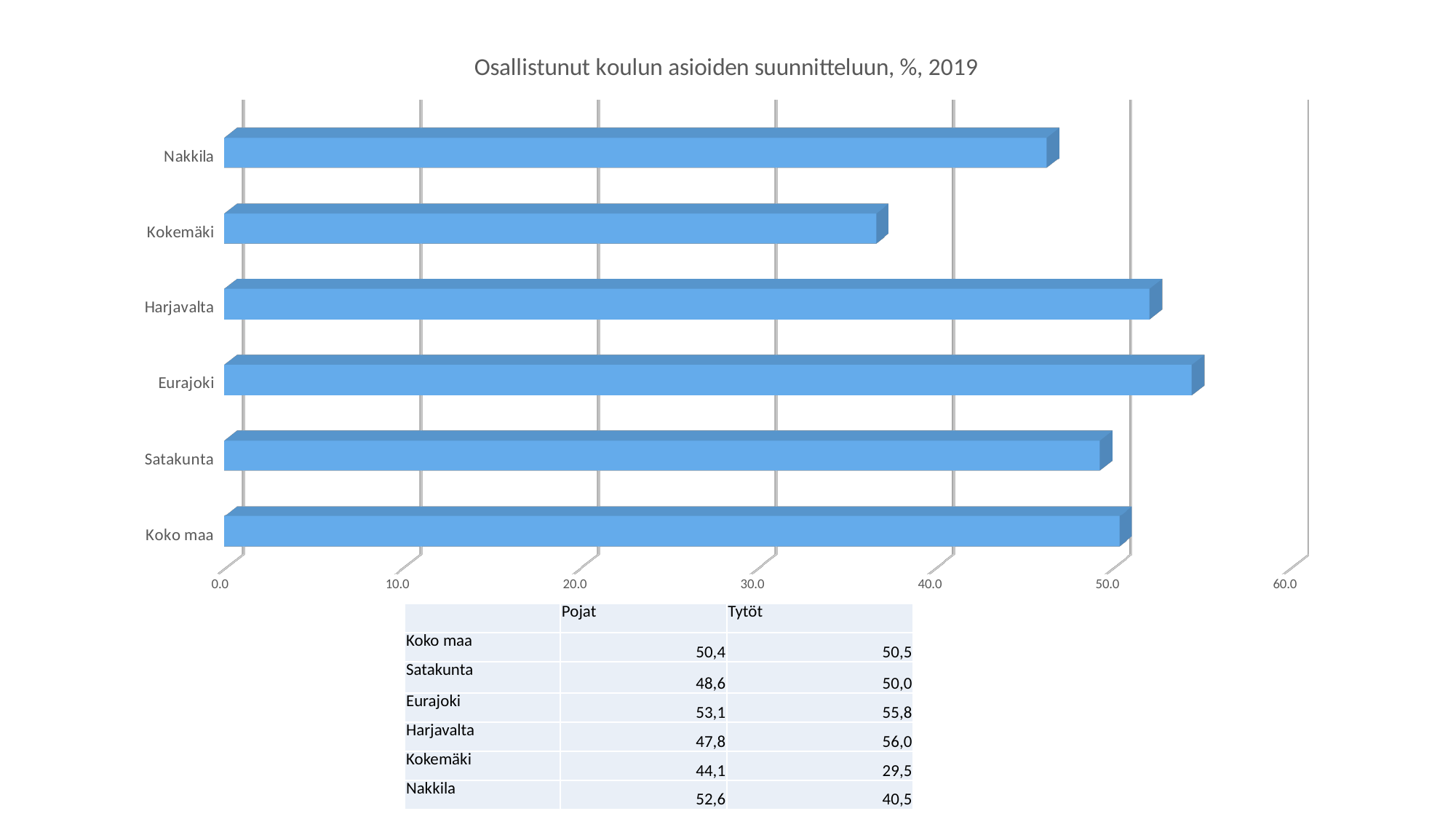
What is the title of the chart? Osallistunut koulun asioiden suunnitteluun, %, 2019 Which has the larger value in the chart, Harjavalta or Nakkila? Harjavalta Which category has the shortest bar in the chart? Kokemäki Is the value for Nakkila greater or less than 50.0? less What kind of chart is shown on the slide? bar chart Which category has the longest bar in the chart? Eurajoki Is the value for Eurajoki greater or less than 50.0? greater How many categories are plotted in the chart? 6 Which has the larger value in the chart, Nakkila or Kokemäki? Nakkila What is the highest value shown on the horizontal axis of the chart? 60.0 Is the value for Kokemäki greater or less than 40.0? less